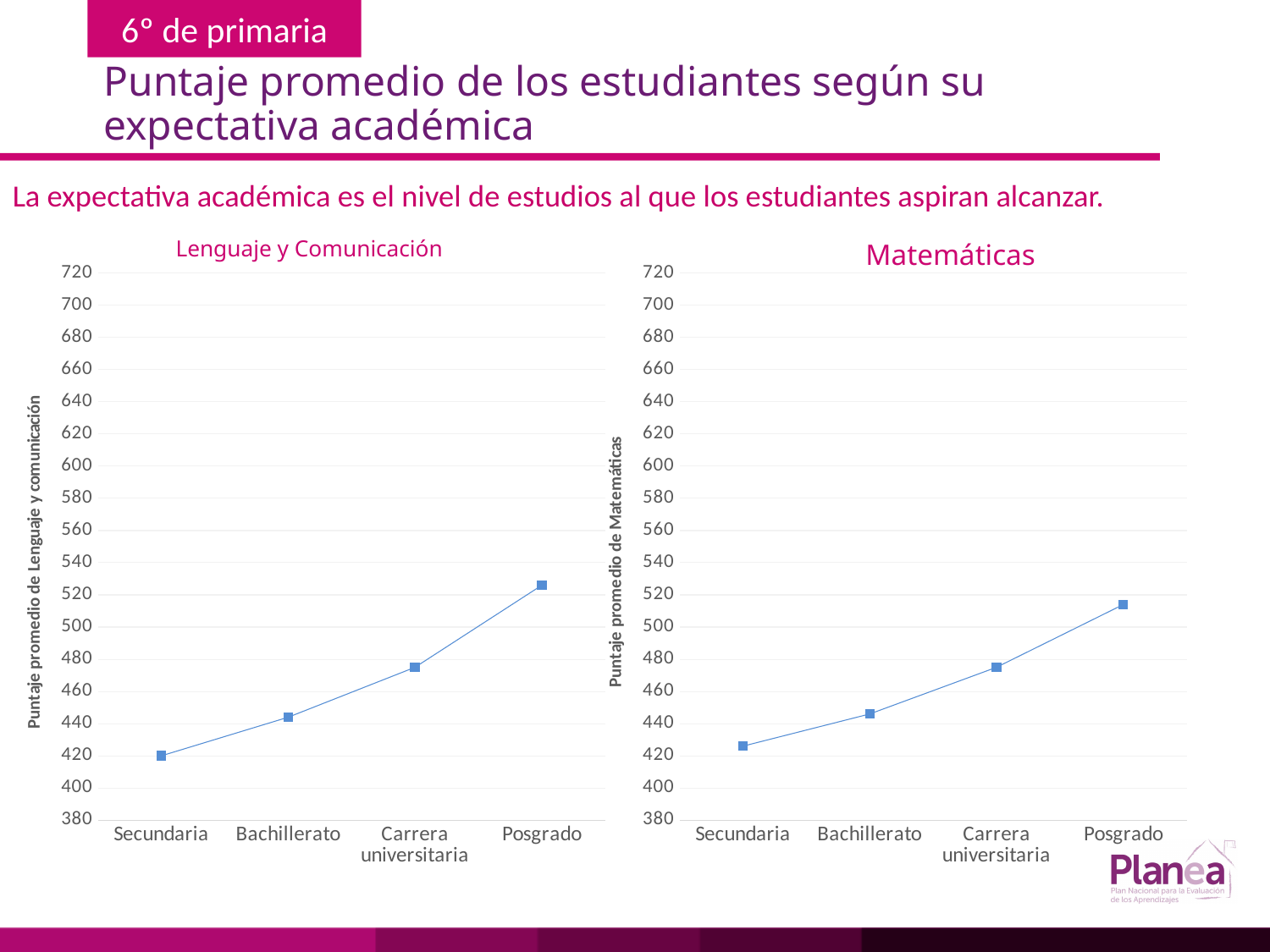
In the 'Matemáticas' chart, is the value for Posgrado greater or less than 500? greater In the 'Matemáticas' chart, is the value for Bachillerato greater or less than 460? less In the 'Lenguaje y Comunicación' chart, do the values rise or fall from Secundaria to Posgrado? rise In the 'Matemáticas' chart, which category has the highest average score? Posgrado In the 'Lenguaje y Comunicación' chart, which category has the lowest average score? Secundaria In the 'Matemáticas' chart, which category has the lowest average score? Secundaria In the 'Lenguaje y Comunicación' chart, which is larger, the value for Bachillerato or the value for Carrera universitaria? Carrera universitaria In the 'Lenguaje y Comunicación' chart, which category has the highest average score? Posgrado How many categories are shown on the x axis of the 'Matemáticas' chart? 4 What is the y-axis label of the 'Matemáticas' chart? Puntaje promedio de Matemáticas What kind of chart is the 'Lenguaje y Comunicación' chart? line chart In the 'Lenguaje y Comunicación' chart, is the value for Secundaria greater or less than 440? less